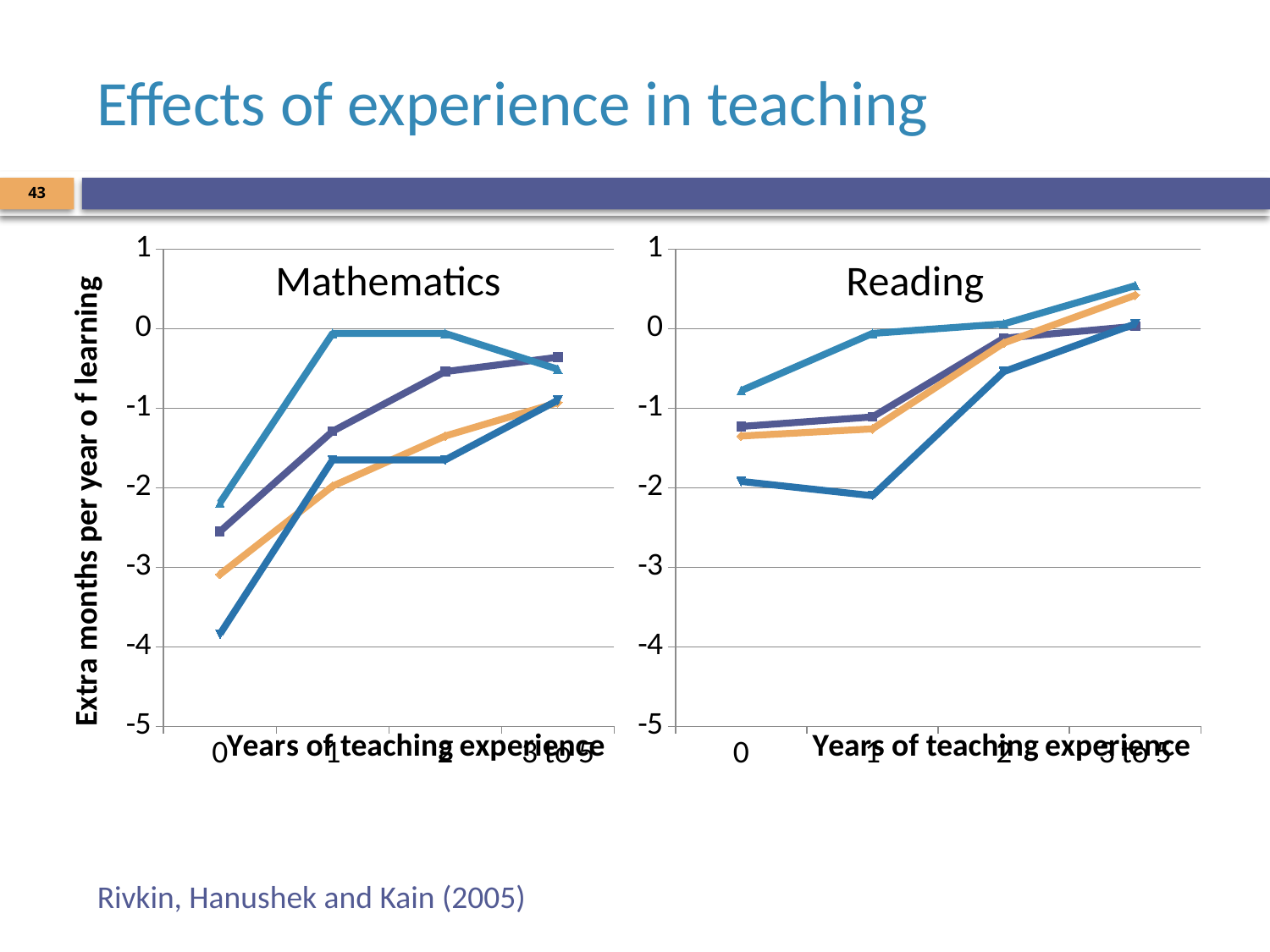
What kind of chart is the Reading chart? line chart What kind of chart is the Mathematics chart? line chart In the Mathematics chart, is the lowest line's value at 0 years of experience greater or less than -3? less In the Mathematics chart, do the lines generally rise or fall as years of teaching experience increase? rise What is the x-axis label of the Reading chart? Years of teaching experience In the Reading chart, do the lines generally rise or fall as years of teaching experience increase? rise In the Mathematics chart, is the highest line's value at 0 years of experience greater or less than -3? greater In the Reading chart, is the highest line's value at 0 years of experience greater or less than -1? greater What is the y-axis label shared by the charts on the slide? Extra months per year of learning How many categories are shown on the x axis of the Mathematics chart? 4 How many lines are plotted on the Reading chart? 4